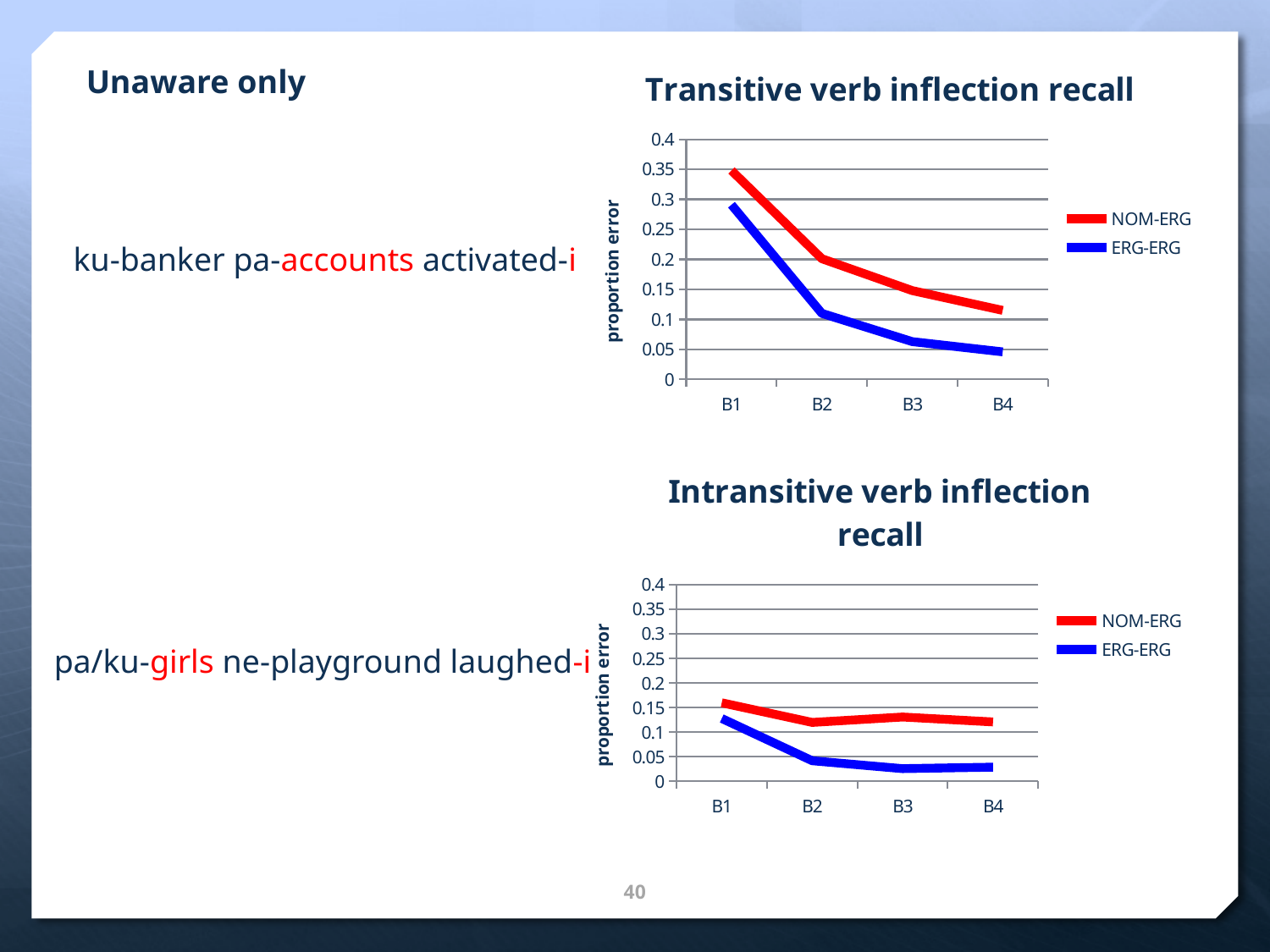
In the 'Transitive verb inflection recall' chart, which series has the higher value at B3, NOM-ERG or ERG-ERG? NOM-ERG In the 'Intransitive verb inflection recall' chart, which series has the lower value at B2, NOM-ERG or ERG-ERG? ERG-ERG How many categories are shown on the x axis of the 'Intransitive verb inflection recall' chart? 4 In the 'Transitive verb inflection recall' chart, is the NOM-ERG value at B1 greater or less than 0.3? greater In the 'Intransitive verb inflection recall' chart, is the ERG-ERG value at B3 greater or less than 0.05? less In the 'Transitive verb inflection recall' chart, does the NOM-ERG line rise or fall from B1 to B4? fall In the 'Transitive verb inflection recall' chart, at which category is the ERG-ERG value highest? B1 What is the y-axis label of the 'Intransitive verb inflection recall' chart? proportion error In the 'Transitive verb inflection recall' chart, is the ERG-ERG value at B2 greater or less than 0.15? less What kind of chart is the 'Transitive verb inflection recall' chart? line chart How many series does the legend of the 'Transitive verb inflection recall' chart list? 2